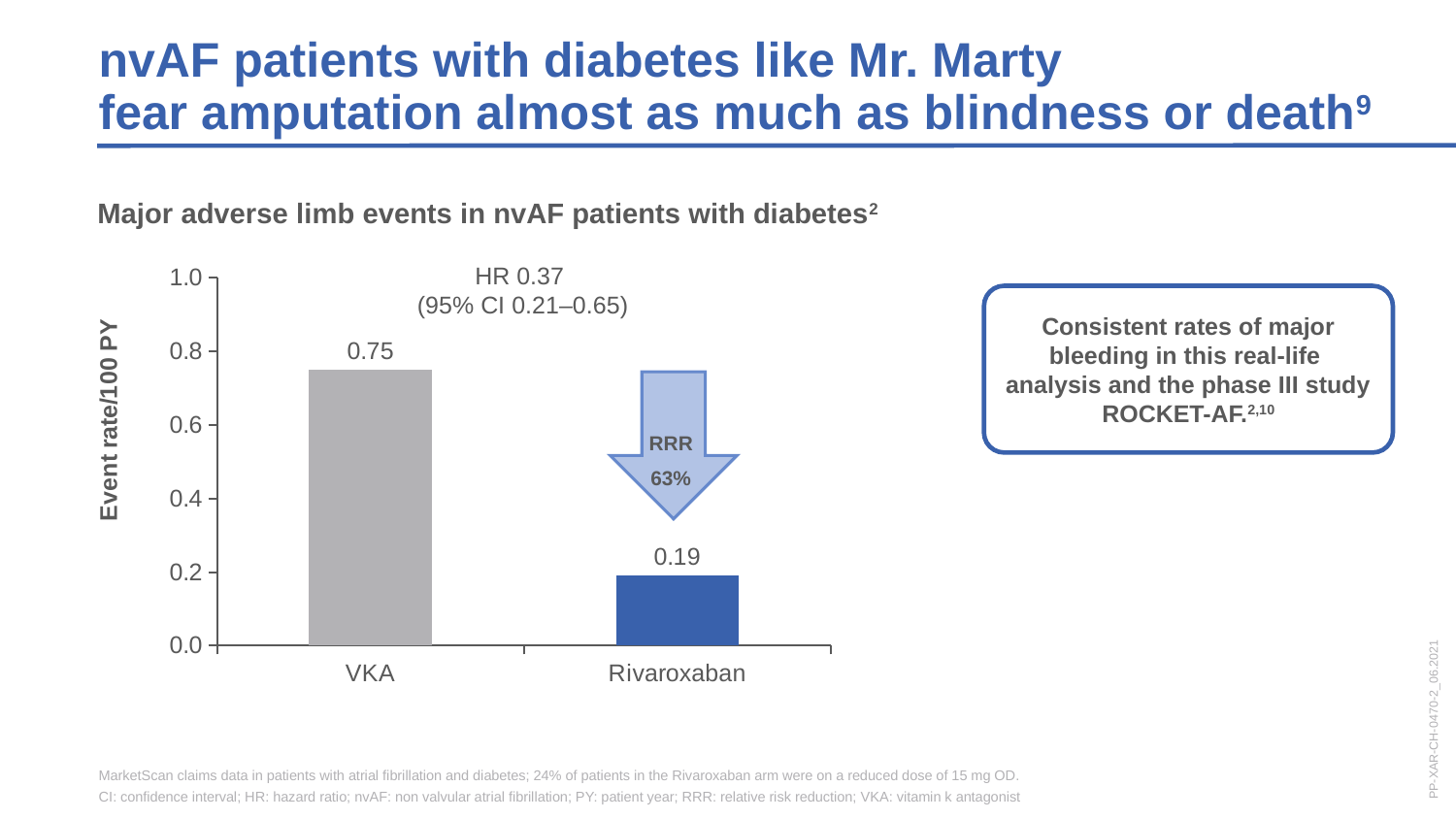
How many treatment categories are shown on the chart? 2 What is the label of the y-axis? Event rate/100 PY What kind of chart is shown on the slide? Bar chart What is the event rate per 100 PY for Rivaroxaban? 0.19 Is the event rate for VKA greater or less than 0.6? greater What is the event rate per 100 PY for VKA? 0.75 Which treatment has the lower event rate? Rivaroxaban What is the difference in event rate between VKA and Rivaroxaban? 0.56 What is the hazard ratio shown on the chart? 0.37 Is the event rate for Rivaroxaban greater or less than 0.2? less Which treatment has the higher event rate? VKA What relative risk reduction (RRR) is shown in the arrow on the chart? 63%